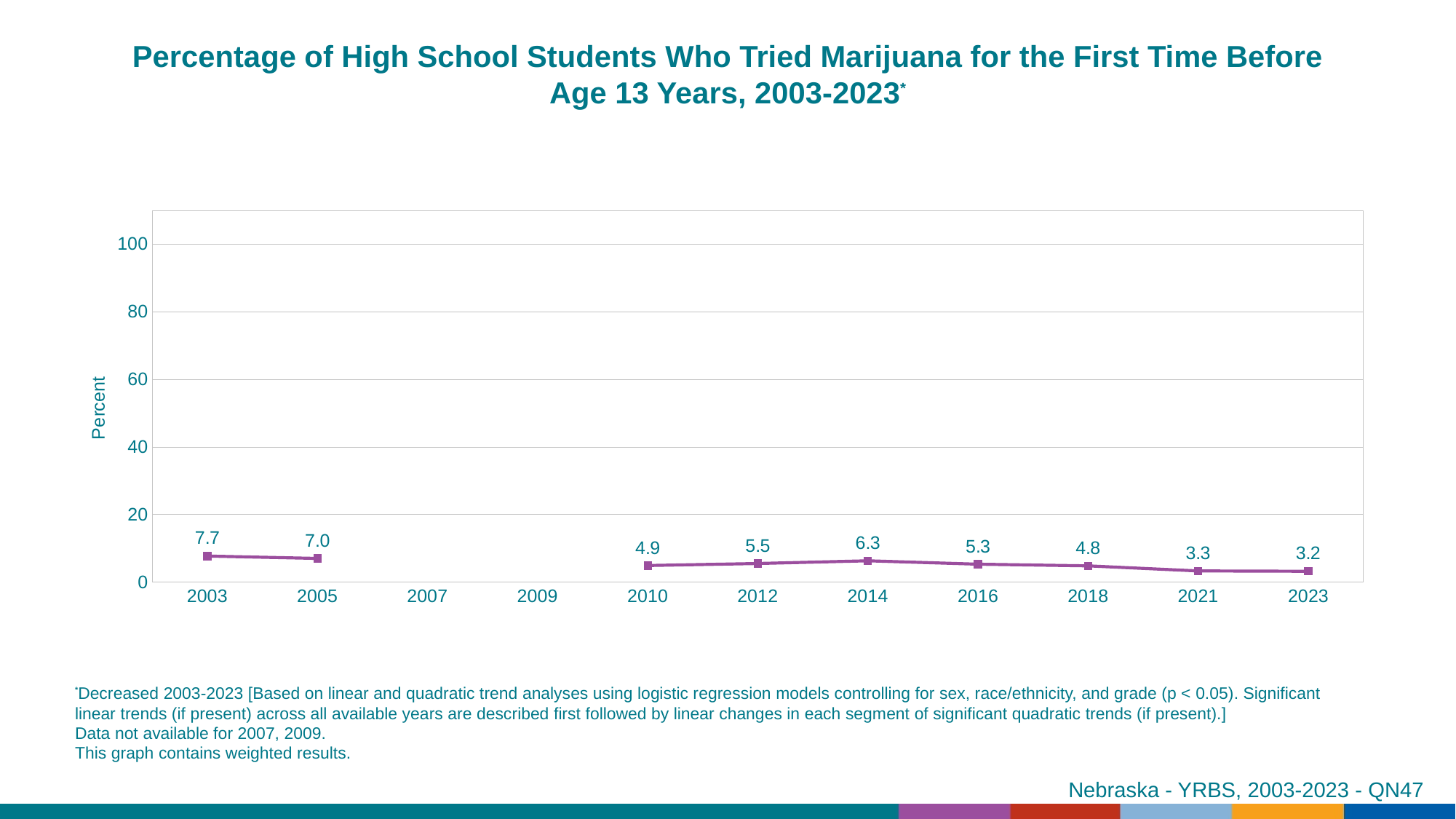
Which year has the lowest plotted value? 2023 What is the difference between the values for 2003 and 2023? 4.5 Which year has the highest plotted value? 2003 Which years are listed on the x axis but have no data plotted? 2007 and 2009 Do the plotted values generally rise or fall from 2003 to 2023? fall Which year has a larger value, 2012 or 2016? 2012 What kind of chart is shown on the slide? line chart What is the value plotted for 2014? 6.3 What percentage of high school students tried marijuana for the first time before age 13 in 2003? 7.7 Is the value for 2010 greater or less than 20? less How many years have data points plotted on the chart? 9 What is the value plotted for 2023? 3.2